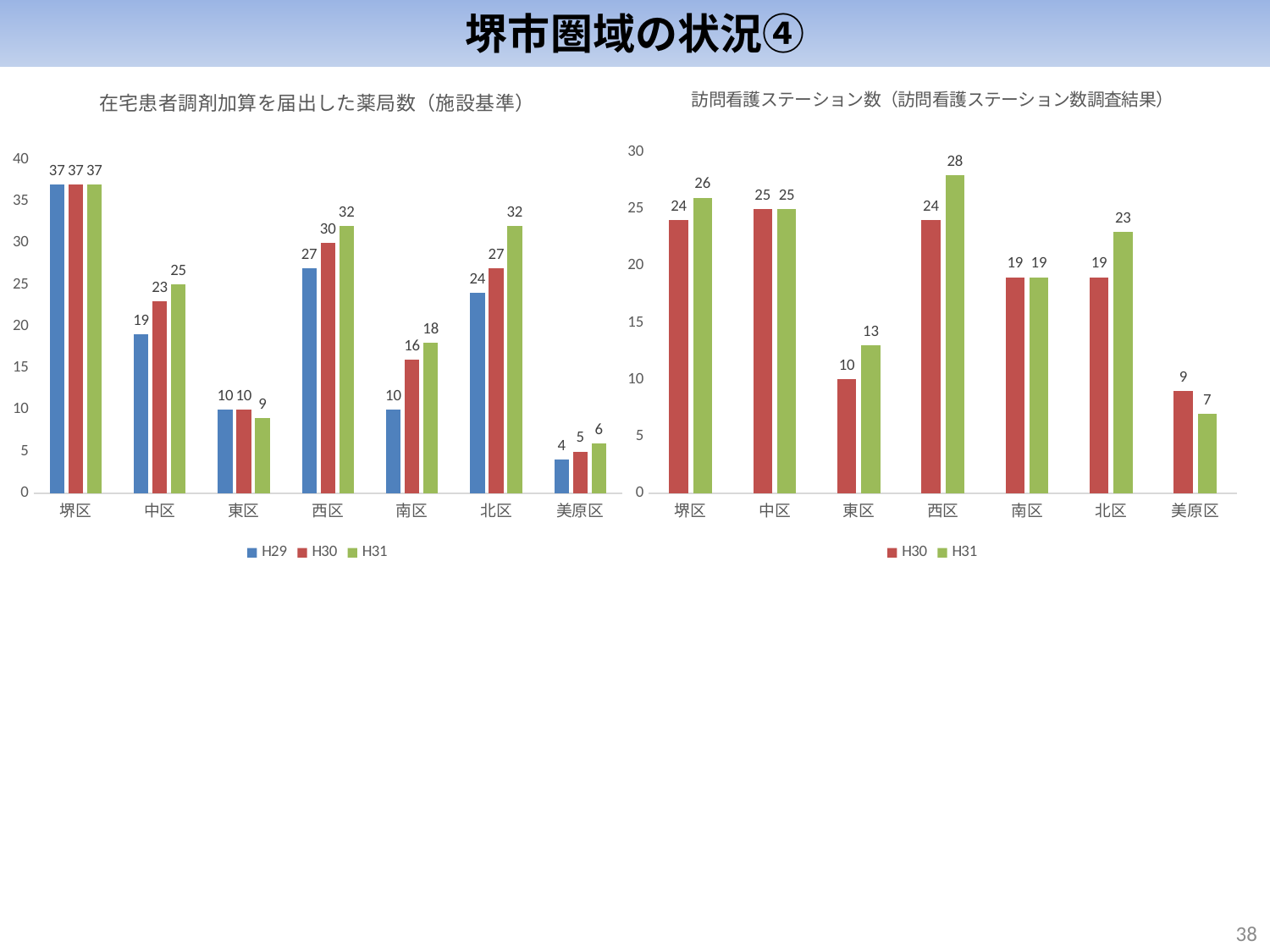
In the right chart (訪問看護ステーション数), which is larger for 北区: the H30 value or the H31 value? H31 What kind of chart is the right chart (訪問看護ステーション数)? Bar chart In the left chart (在宅患者調剤加算を届出した薬局数), how many districts are shown on the x axis? 7 In the left chart (在宅患者調剤加算を届出した薬局数), which district has the lowest H30 value? 美原区 In the left chart (在宅患者調剤加算を届出した薬局数), what is the difference between the H31 and H29 values for 南区? 8 In the right chart (訪問看護ステーション数), which district has the highest H31 value? 西区 In the left chart (在宅患者調剤加算を届出した薬局数), what is the H29 value for 北区? 24 In the right chart (訪問看護ステーション数), what is the H31 value for 西区? 28 In the left chart (在宅患者調剤加算を届出した薬局数), what is the H31 value for 中区? 25 In the right chart (訪問看護ステーション数), how many series does the legend list? 2 In the right chart (訪問看護ステーション数), what is the difference between the H30 and H31 values for 美原区? 2 In the left chart (在宅患者調剤加算を届出した薬局数), how many series does the legend list? 3